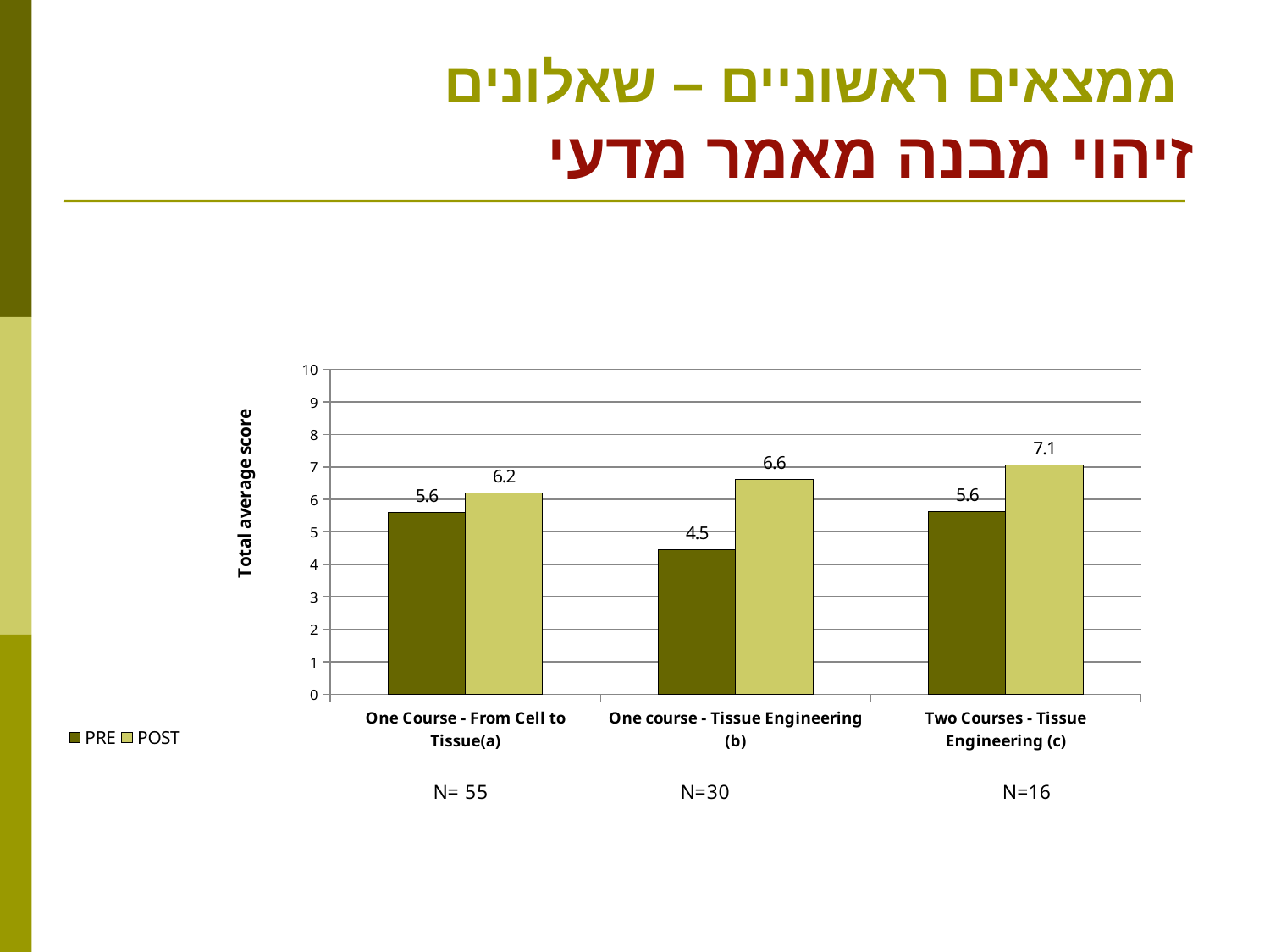
Which category has the highest POST value? Two Courses - Tissue Engineering (c) Which category has the lowest PRE value? One course - Tissue Engineering (b) How many categories are shown on the x axis? 3 What is the difference between the POST and PRE values for One course - Tissue Engineering (b)? 2.1 What is the difference between the POST and PRE values for Two Courses - Tissue Engineering (c)? 1.5 What is the POST value for One Course - From Cell to Tissue(a)? 6.2 What is the label of the y axis? Total average score What kind of chart is shown on the slide? Bar chart How many series does the legend list? 2 What is the PRE value for One course - Tissue Engineering (b)? 4.5 What is the POST value for Two Courses - Tissue Engineering (c)? 7.1 Which is larger: the POST value for One Course - From Cell to Tissue(a) or the POST value for One course - Tissue Engineering (b)? One course - Tissue Engineering (b)